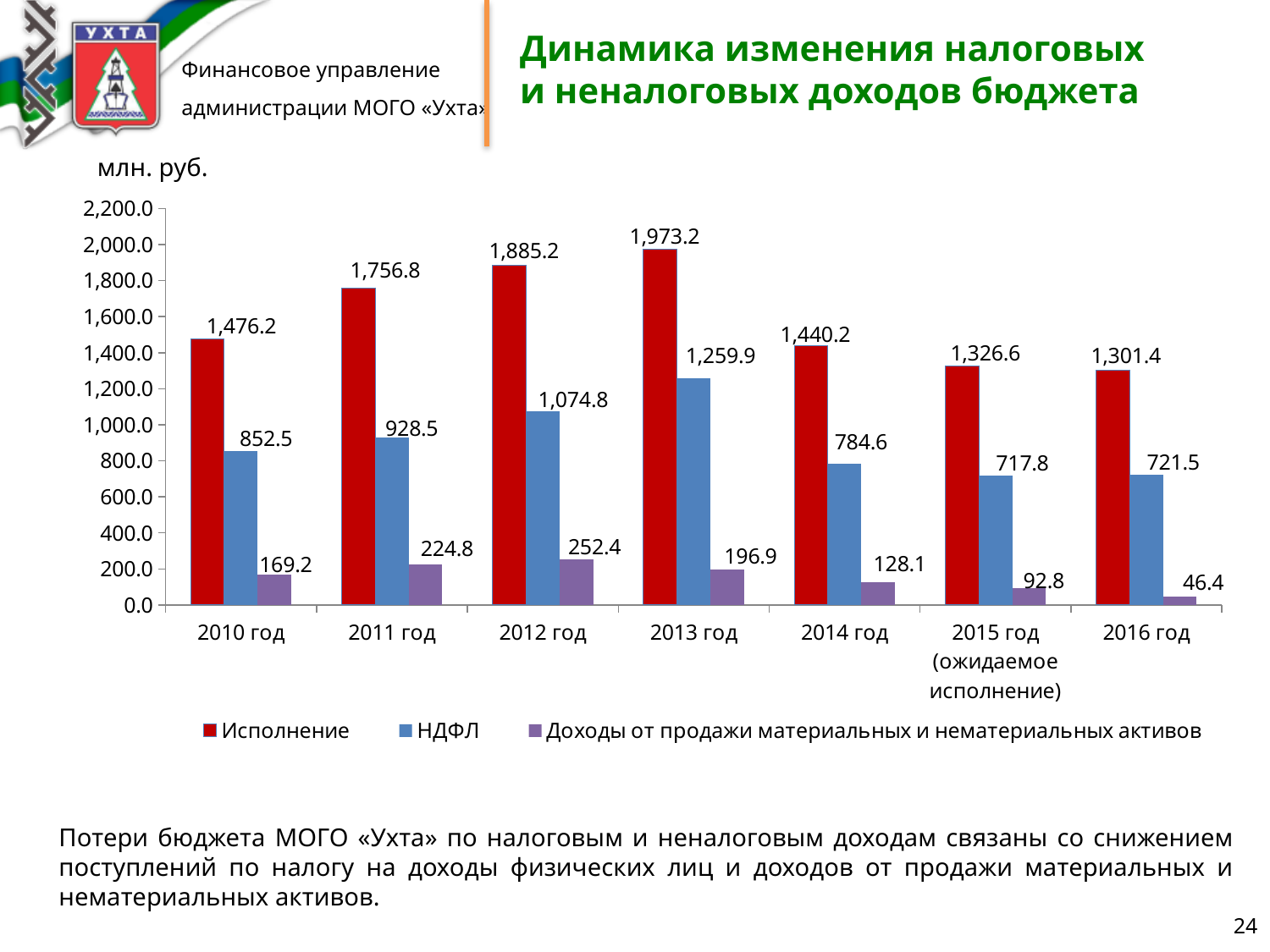
How many year categories are shown on the x axis? 7 What is the value of Исполнение for 2013 год? 1,973.2 In which year is Доходы от продажи материальных и нематериальных активов the lowest? 2016 год Which is larger: Исполнение in 2011 год or in 2012 год? 2012 год What type of chart is shown on the slide? Bar chart How does Исполнение change from 2013 год to 2016 год? It falls What is the difference between Исполнение in 2013 год and in 2016 год? 671.8 In which year is Исполнение the highest? 2013 год Is the value of НДФЛ for 2015 год greater or less than 800.0? less What is the value of НДФЛ for 2012 год? 1,074.8 How many series does the legend list? 3 What is the value of Доходы от продажи материальных и нематериальных активов for 2016 год? 46.4